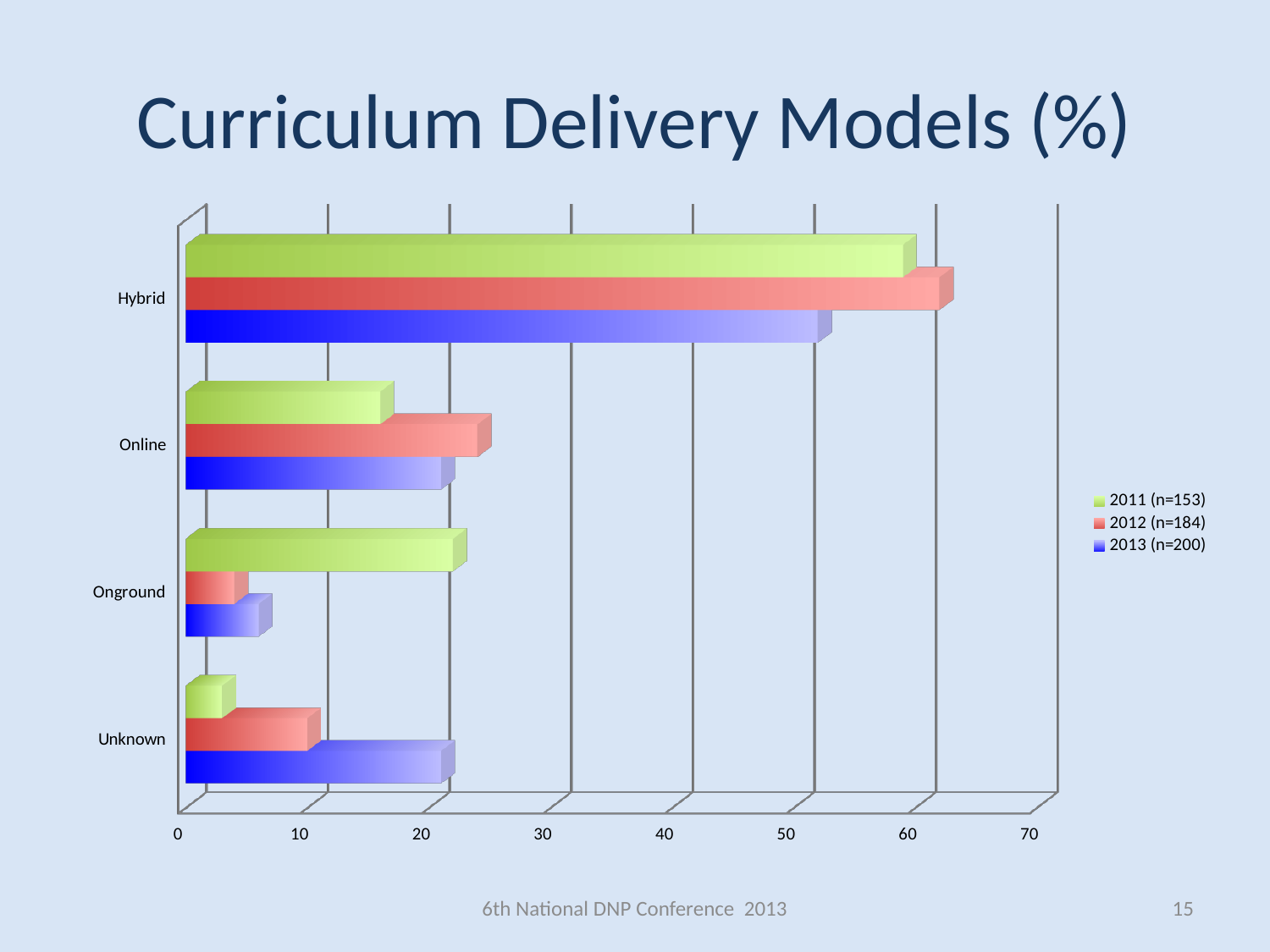
For the Hybrid category, which series has the larger value: 2012 (n=184) or 2013 (n=200)? 2012 (n=184) For the Onground category, which series has the larger value: 2011 (n=153) or 2012 (n=184)? 2011 (n=153) What kind of chart is shown on the slide? Bar chart Which category has the lowest value for the 2011 (n=153) series? Unknown Is the value for Hybrid in the 2011 (n=153) series greater or less than 50? greater Is the value for Unknown in the 2013 (n=200) series greater or less than 10? greater Is the value for Onground in the 2012 (n=184) series greater or less than 10? less Which category has the highest value for the 2013 (n=200) series? Hybrid How many series does the legend list? 3 How many categories are shown on the chart? 4 What is the title of the chart? Curriculum Delivery Models (%)